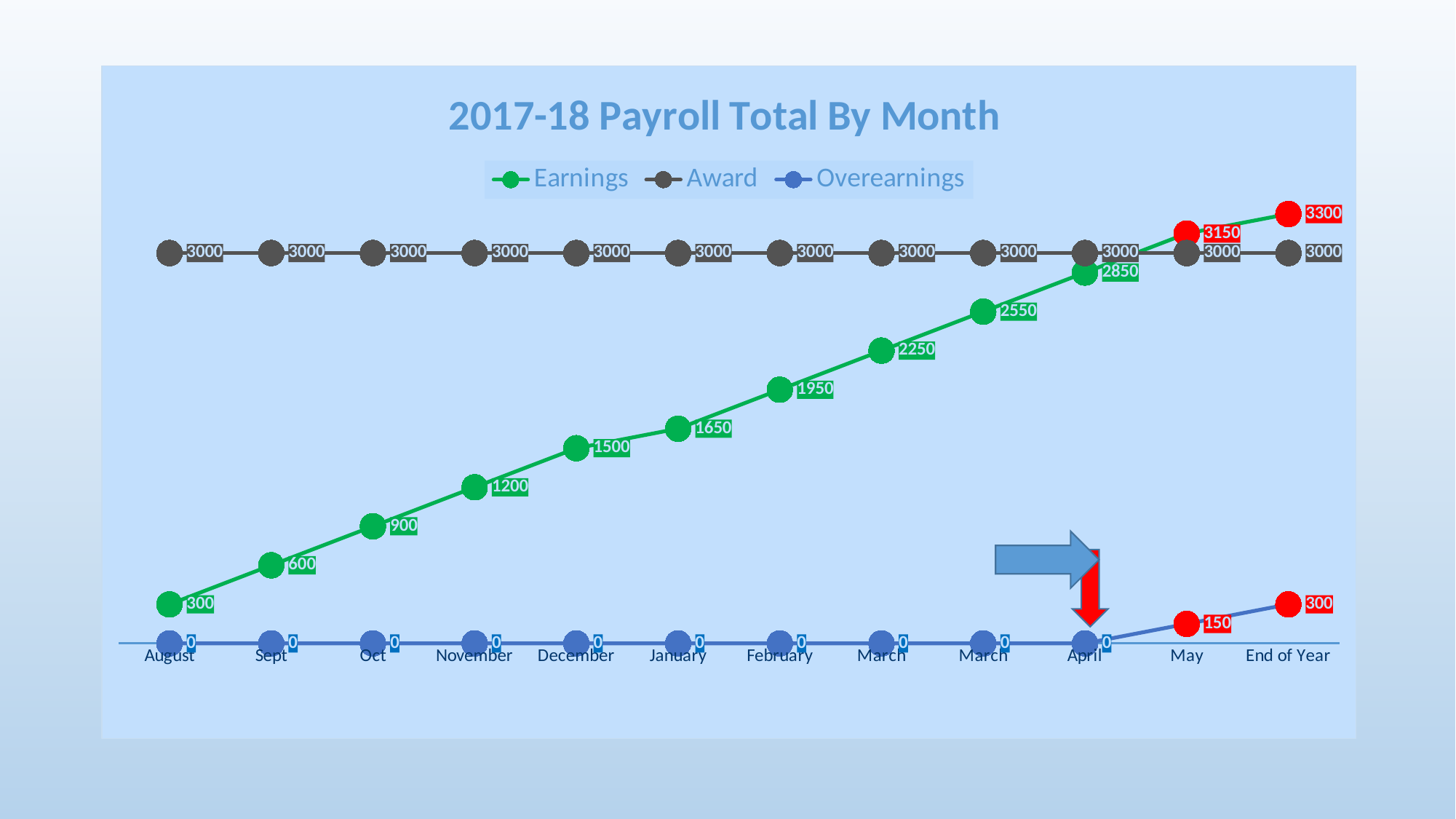
What is the Earnings value for December? 1500 What is the difference between the Earnings value at End of Year and the Award value at End of Year? 300 What kind of chart is shown on the slide? Line chart What is the Overearnings value at End of Year? 300 Which category has the lowest Earnings value? August How many series does the legend list? 3 Which is larger in April, the Earnings value or the Award value? Award Which category has the highest Earnings value? End of Year How many categories are shown on the x axis? 12 Do the Earnings values rise or fall from August to End of Year? Rise What is the Award value for January? 3000 What is the Earnings value for May? 3150